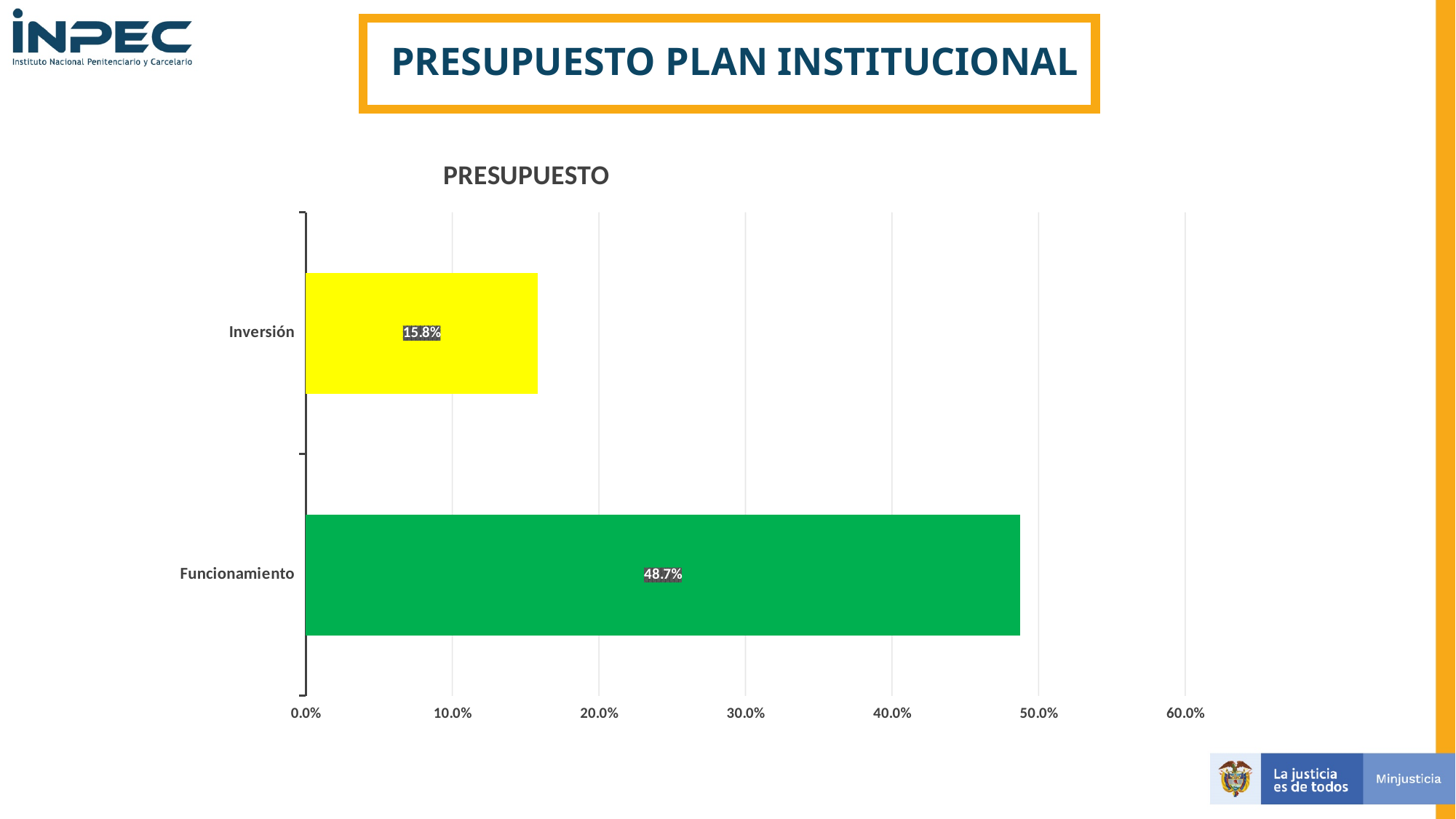
What is the value for Funcionamiento? 48.7% What kind of chart is shown on the slide? bar chart What is the title of the chart? PRESUPUESTO Is the value for Inversión greater or less than 20.0%? less What is the value for Inversión? 15.8% Which is larger, the value for Inversión or the value for Funcionamiento? Funcionamiento Is the value for Funcionamiento greater or less than 40.0%? greater Which category has the highest value? Funcionamiento What colour is the bar for Funcionamiento? green What is the difference between the values for Funcionamiento and Inversión? 32.9% How many categories are shown in the chart? 2 Which category has the lowest value? Inversión